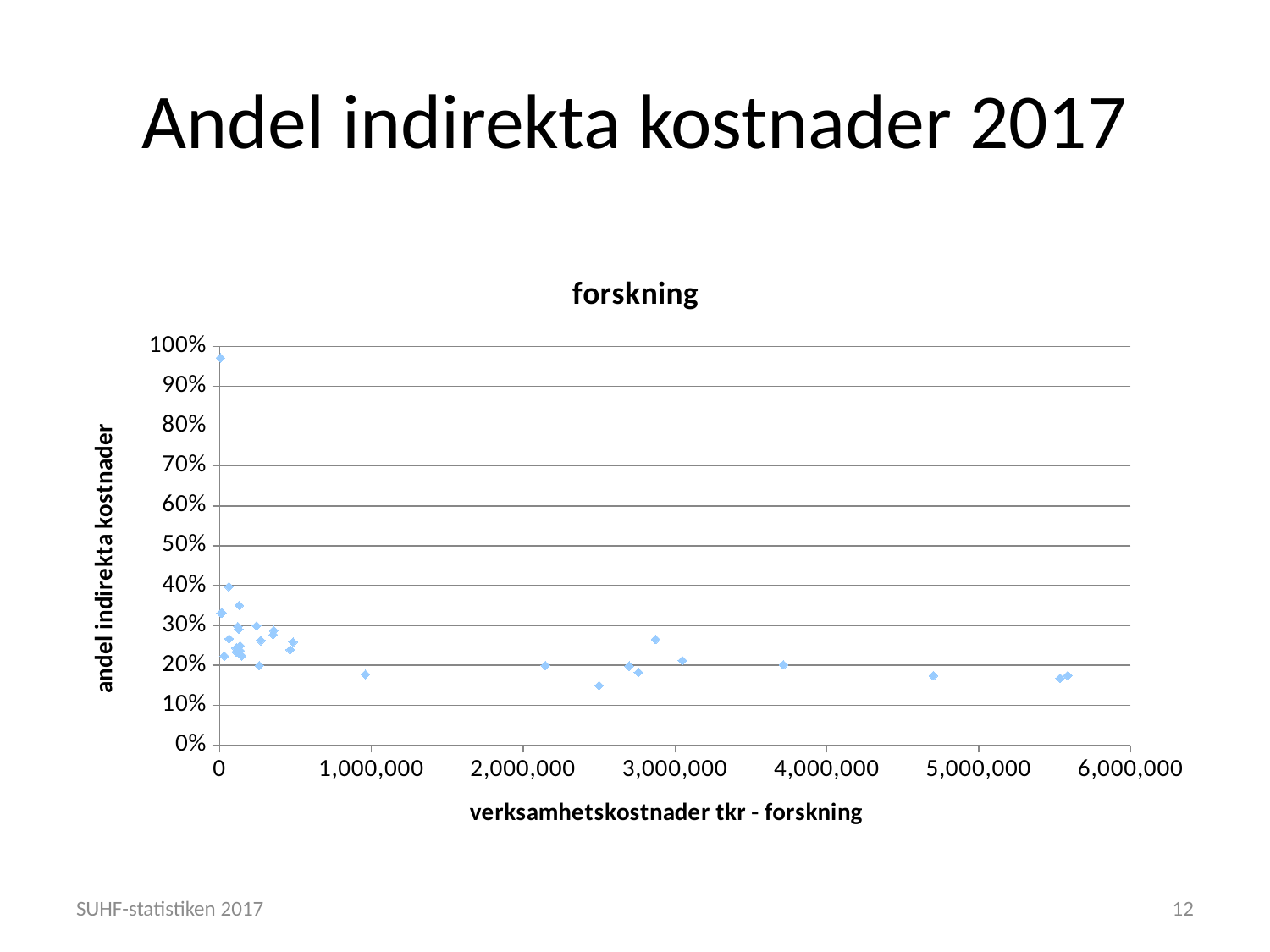
What is the highest value shown on the y axis of the chart? 100% Are the points plotted near 5,500,000 on the x axis greater or less than 20% andel indirekta kostnader? less Is the highest point on the chart greater or less than 90% andel indirekta kostnader? greater What kind of chart is shown on the slide? scatter chart What is the label of the x axis of the chart? verksamhetskostnader tkr - forskning Is the point plotted near 1,000,000 on the x axis greater or less than 20% andel indirekta kostnader? less Do the points with larger verksamhetskostnader tend to have higher or lower andel indirekta kostnader than the points near 0? lower What is the title of the chart? forskning Is the highest point on the chart located near the left or the right end of the x axis? left